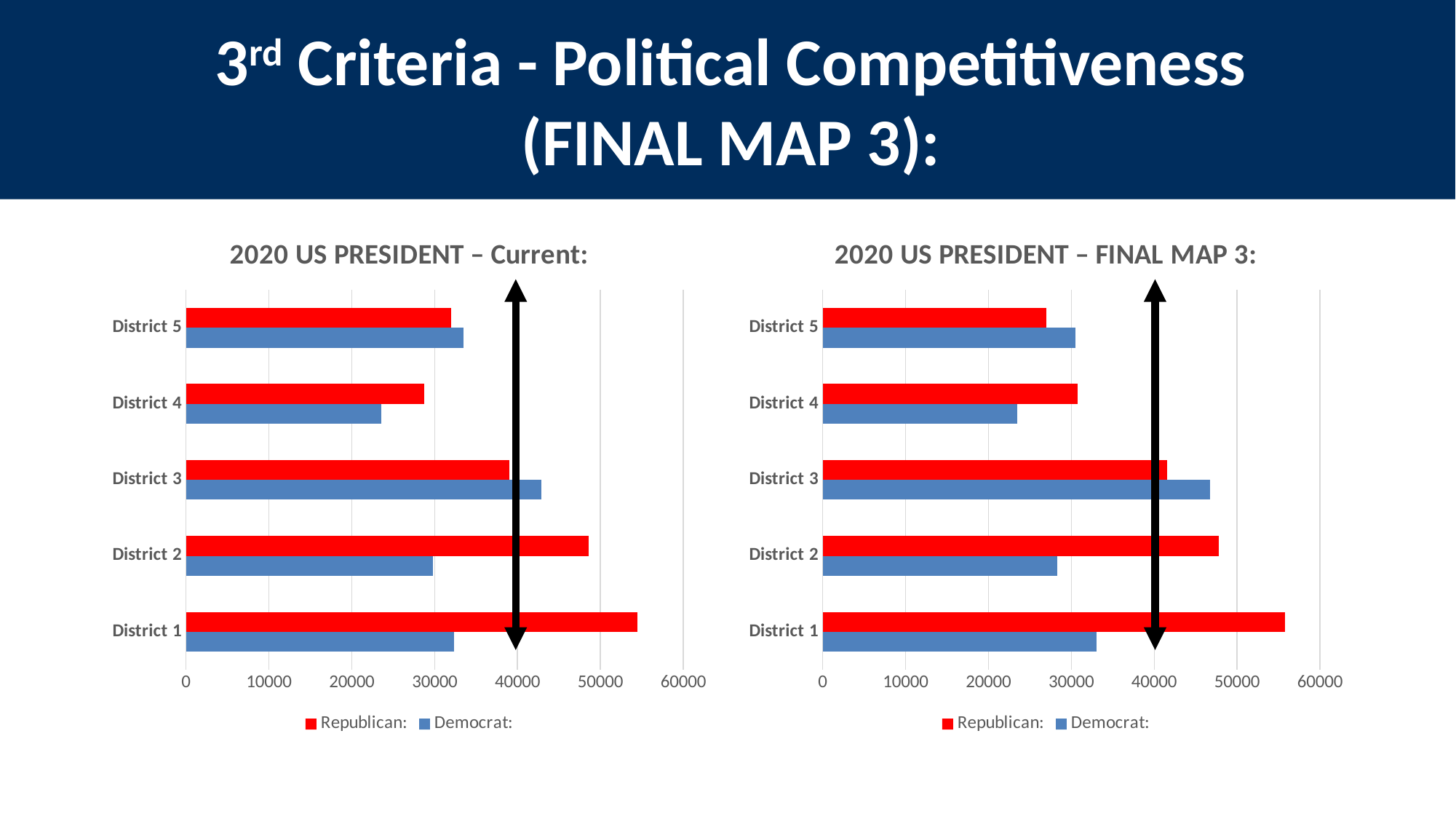
In the "2020 US PRESIDENT – FINAL MAP 3:" chart, which is larger for District 3, the Republican or the Democrat value? Democrat In the "2020 US PRESIDENT – Current:" chart, is the Republican value for District 1 greater or less than 50000? greater In the "2020 US PRESIDENT – Current:" chart, which district has the lowest Democrat value? District 4 In the "2020 US PRESIDENT – Current:" chart, which is larger for District 2, the Republican or the Democrat value? Republican In the "2020 US PRESIDENT – FINAL MAP 3:" chart, is the Republican value for District 5 greater or less than 30000? less What kind of chart is the "2020 US PRESIDENT – Current:" chart? bar chart In the "2020 US PRESIDENT – FINAL MAP 3:" chart, which district has the highest Democrat value? District 3 What colour represents the Democrat series in the charts on the slide? blue In the "2020 US PRESIDENT – Current:" chart, which district has the highest Republican value? District 1 In the "2020 US PRESIDENT – FINAL MAP 3:" chart, which district has the lowest Republican value? District 5 How many districts are shown on the "2020 US PRESIDENT – FINAL MAP 3:" chart? 5 How many series does the legend of the "2020 US PRESIDENT – Current:" chart list? 2